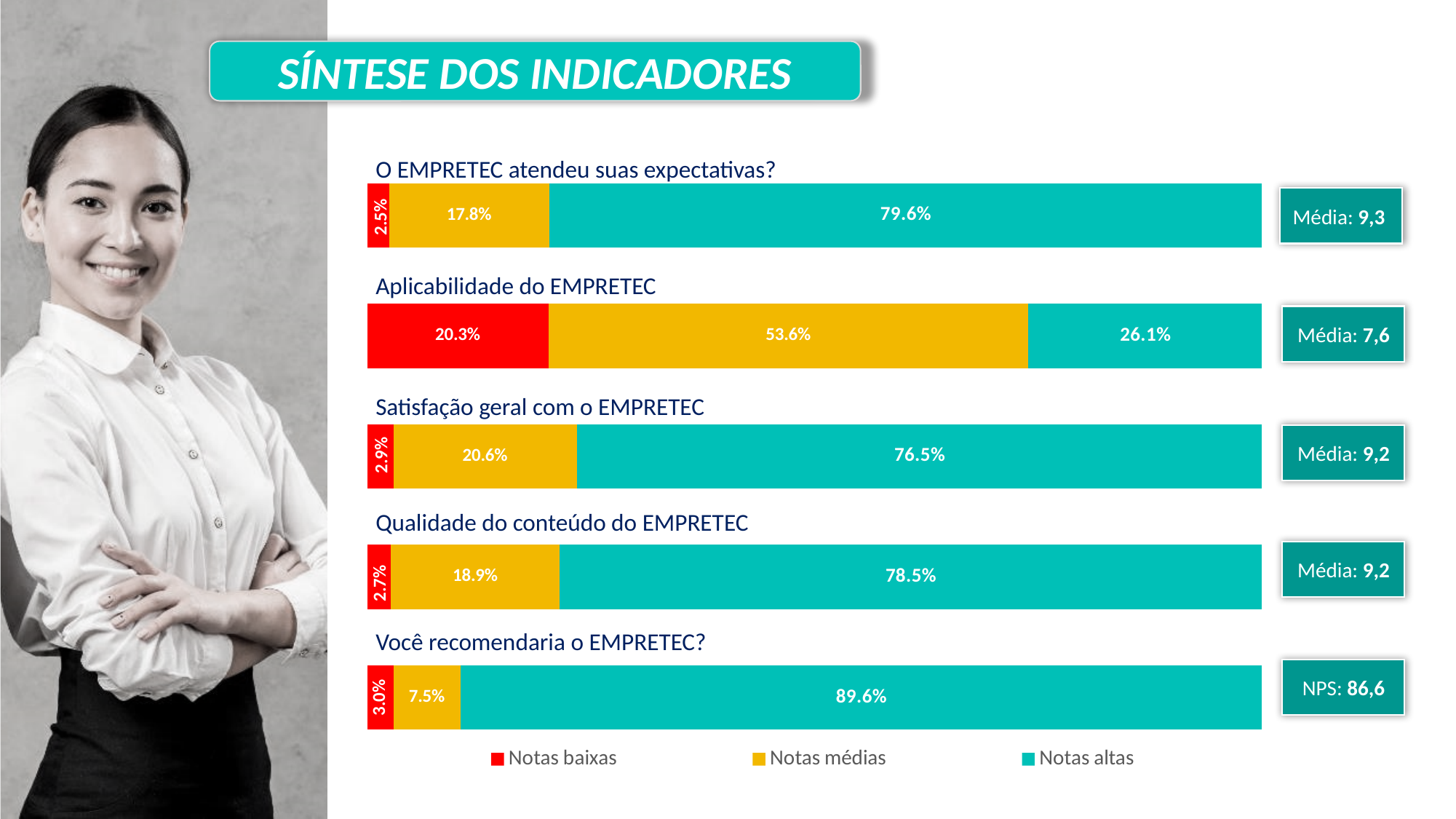
In the chart 'Aplicabilidade do EMPRETEC', what is the value for Notas médias? 53.6% In the chart 'Você recomendaria o EMPRETEC?', what is the difference between Notas altas and Notas médias? 82.1% In the chart 'Você recomendaria o EMPRETEC?', what is the value for Notas altas? 89.6% How many series does the legend list? 3 What is the Média shown next to the chart 'Aplicabilidade do EMPRETEC'? 7,6 What kind of chart is used for 'Satisfação geral com o EMPRETEC'? Stacked bar chart What colour represents Notas altas in the legend? Teal In the chart 'Satisfação geral com o EMPRETEC', what is the value for Notas médias? 20.6% In the chart 'O EMPRETEC atendeu suas expectativas?', what is the value for Notas baixas? 2.5% In the chart 'Aplicabilidade do EMPRETEC', which is larger: Notas baixas or Notas altas? Notas altas In the chart 'Aplicabilidade do EMPRETEC', which series has the lowest value? Notas baixas In the chart 'Qualidade do conteúdo do EMPRETEC', which series has the highest value? Notas altas